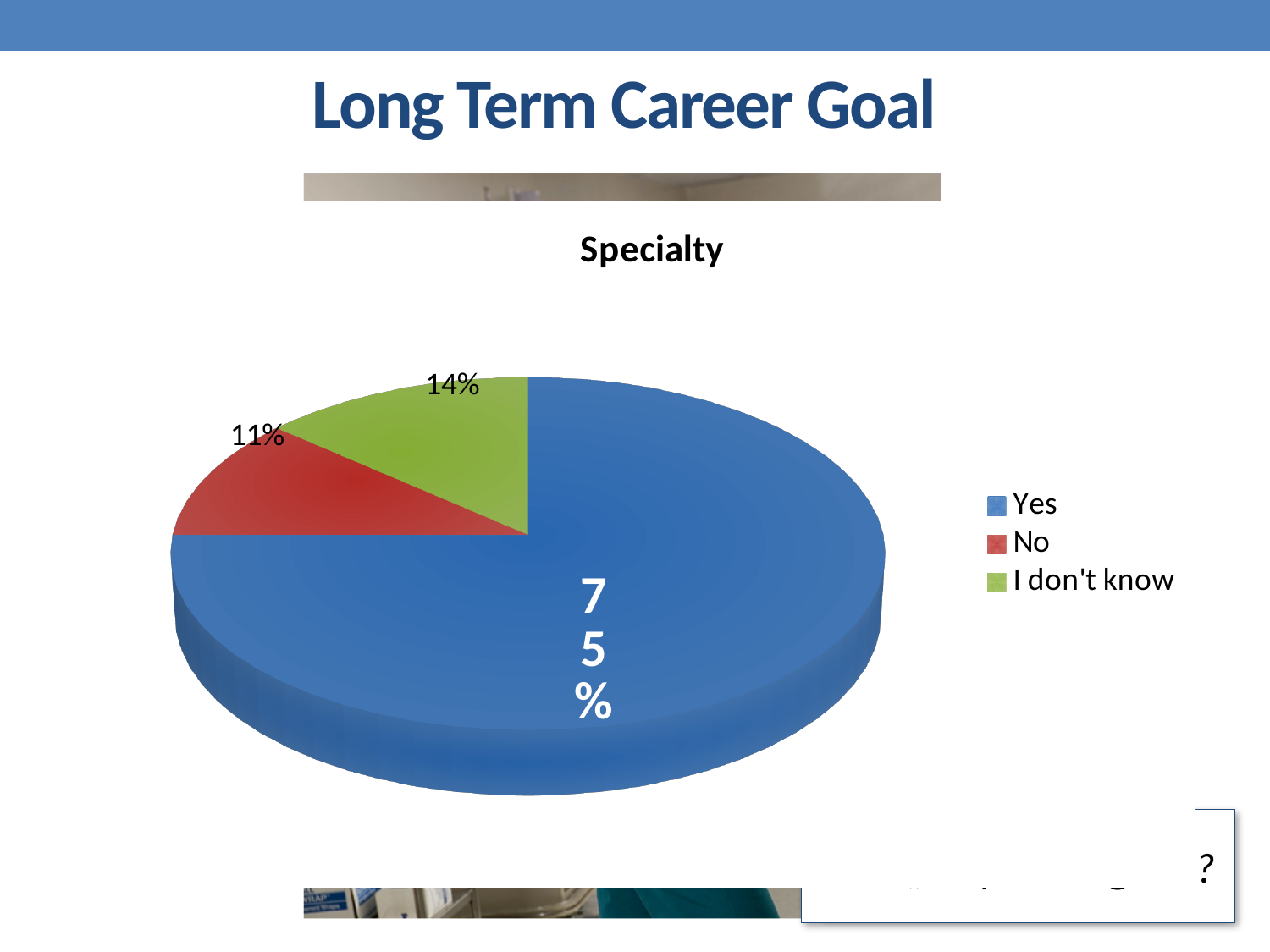
Which is larger, the share for 'No' or the share for 'I don't know'? I don't know What is the difference in percentage points between 'I don't know' and 'No'? 3 How many categories does the legend list? 3 Which category has the largest share of the pie? Yes What is the difference in percentage points between 'Yes' and 'I don't know'? 61 What percentage of the pie is labelled 'I don't know'? 14% Which category has the smallest share of the pie? No What is the title of the chart? Specialty What percentage of the pie is labelled 'No'? 11% What percentage of the pie is labelled 'Yes'? 75% What type of chart is shown on the slide? Pie chart What colour represents the 'No' category? Red